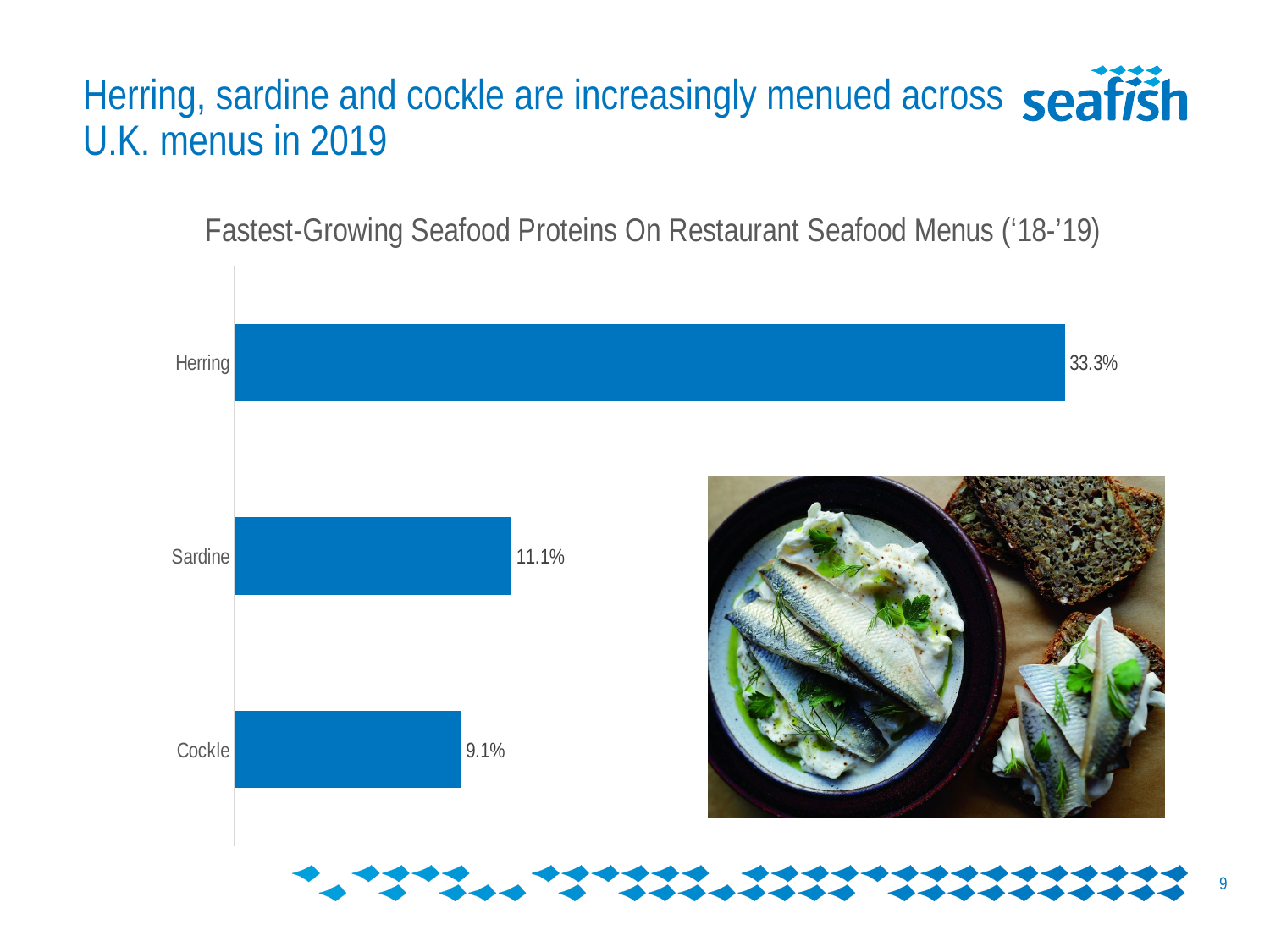
Which category has the highest value? Herring Which category has the lowest value? Cockle What is the value for Cockle? 9.1% How many categories are shown in the chart? 3 What is the title of the chart? Fastest-Growing Seafood Proteins On Restaurant Seafood Menus ('18-'19) What is the difference between the values for Herring and Sardine? 22.2% What is the value for Sardine? 11.1% What colour are the bars in the chart? Blue What is the difference between the values for Sardine and Cockle? 2.0% Which is larger, the value for Sardine or the value for Cockle? Sardine What kind of chart is shown on the slide? Bar chart What is the value for Herring? 33.3%